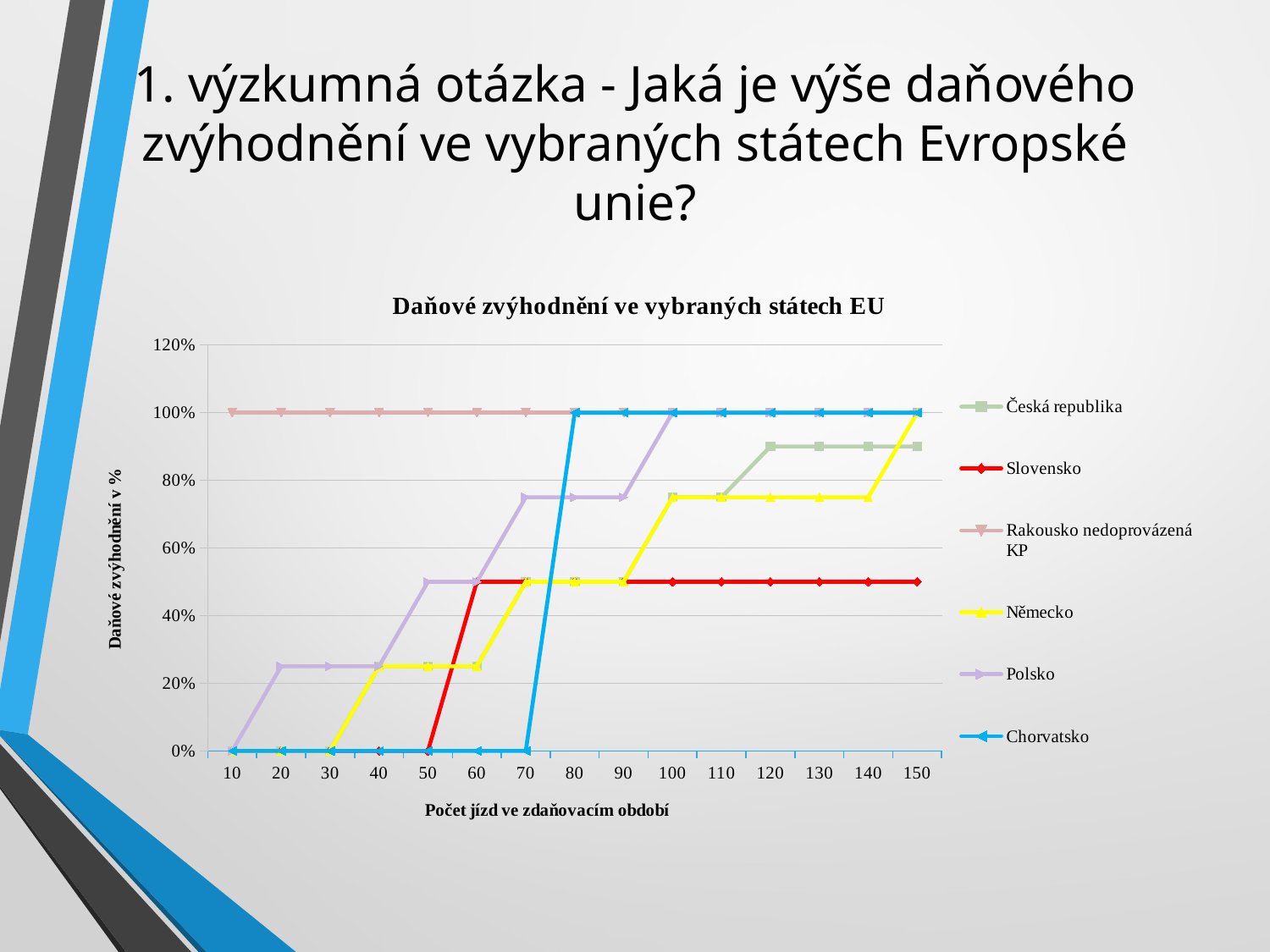
Does the value for Chorvatsko rise or fall as the number of jízd increases from 10 to 150? rise How many series does the legend list? 6 Is the value for Polsko at 70 jízd greater or less than 60%? greater What is the value for Rakousko nedoprovázená KP at 50 jízd? 100% What is the value for Chorvatsko at 80 jízd? 100% Which series has the lowest value at 150 jízd? Slovensko Is the value for Slovensko at 150 jízd greater or less than 60%? less What kind of chart is shown on the slide? line chart What is the title of the chart? Daňové zvýhodnění ve vybraných státech EU At 150 jízd, which is larger: Rakousko nedoprovázená KP or Slovensko? Rakousko nedoprovázená KP How many values are shown on the x axis (Počet jízd ve zdaňovacím období)? 15 What is the value for Chorvatsko at 70 jízd? 0%